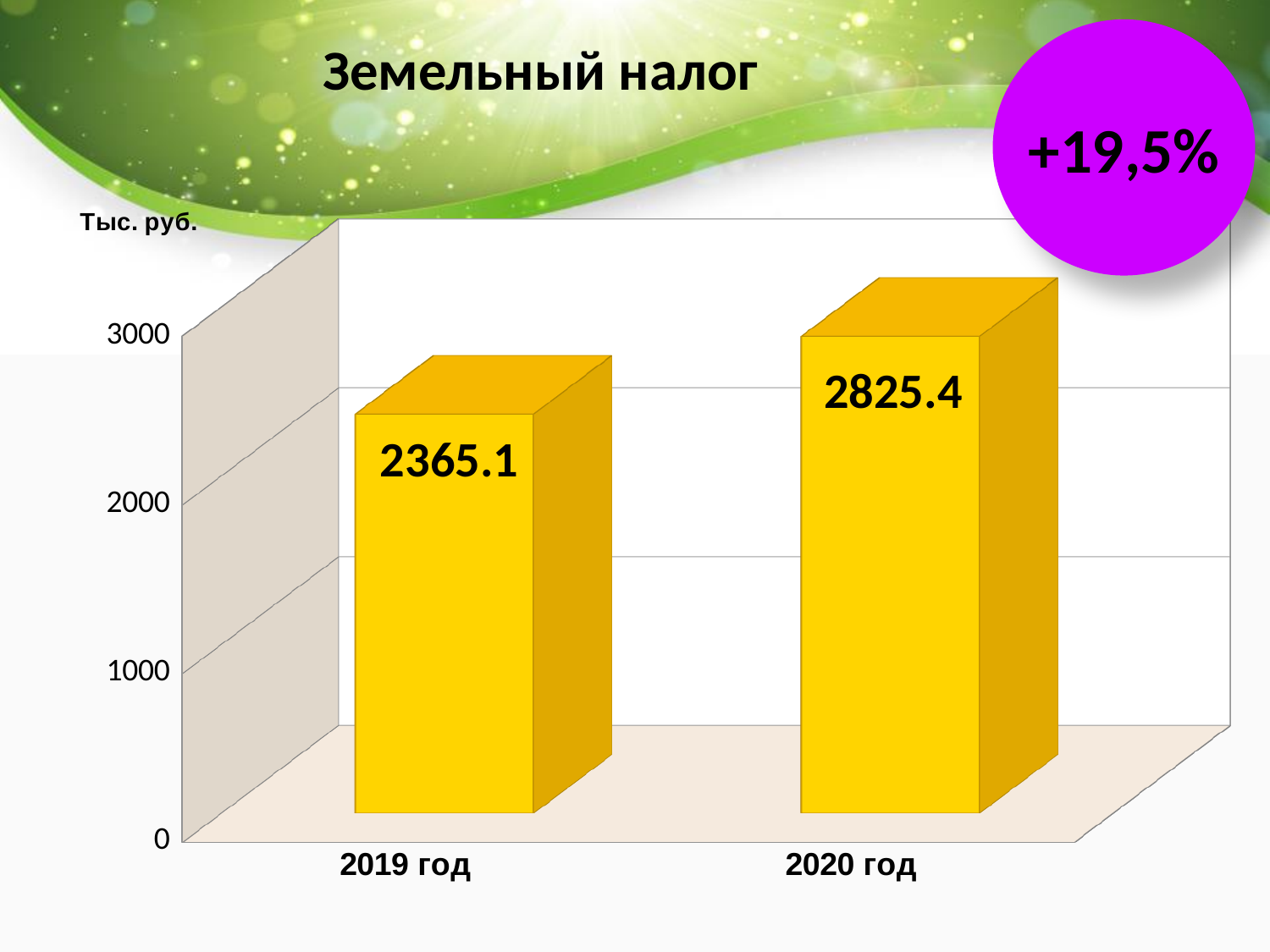
How many categories are shown on the x axis? 2 What is the value for 2020 год? 2825.4 Which year has the lowest value? 2019 год Which year has the highest value? 2020 год What is the title of the chart? Земельный налог Do the values rise or fall from 2019 год to 2020 год? rise What is the difference between the values for 2020 год and 2019 год? 460.3 Is the value for 2020 год greater or less than 3000? less What kind of chart is shown on the slide? bar chart Is the value for 2019 год greater or less than 2000? greater What is the value for 2019 год? 2365.1 Which is larger, the value for 2019 год or the value for 2020 год? 2020 год